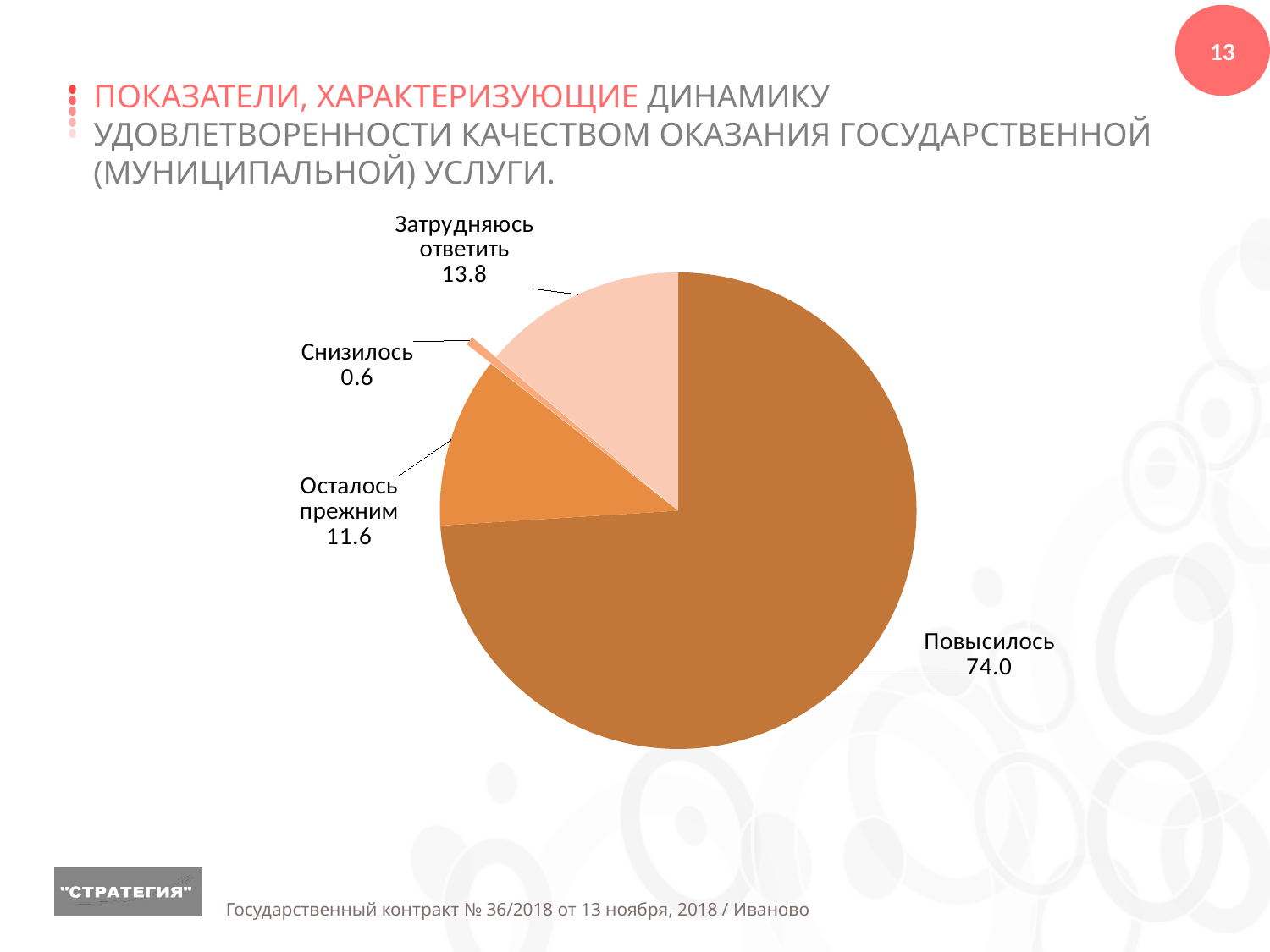
What is the difference between the values for Затрудняюсь ответить and Осталось прежним? 2.2 How many slices does the pie chart have? 4 What is the difference between the values for Повысилось and Осталось прежним? 62.4 What is the value for Повысилось? 74.0 What kind of chart is shown on the slide? pie chart What is the total of all the slice values shown on the pie chart? 100.0 Which is larger, the value for Затрудняюсь ответить or the value for Осталось прежним? Затрудняюсь ответить Which category has the smallest slice of the pie? Снизилось What is the value for Снизилось? 0.6 What is the value for Затрудняюсь ответить? 13.8 Which category has the largest slice of the pie? Повысилось What is the value for Осталось прежним? 11.6